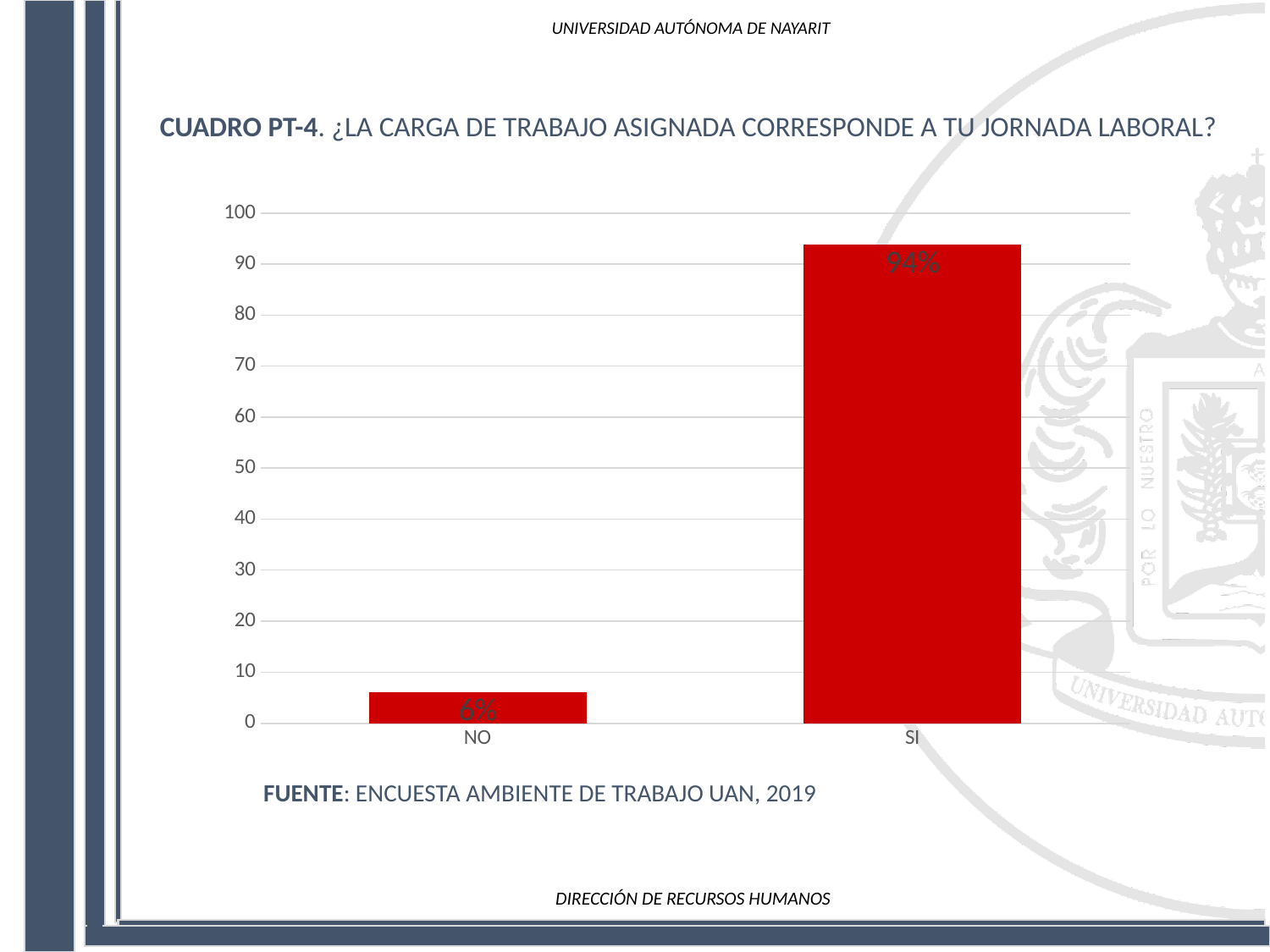
What is the value for SI? 94% Which category has the highest value? SI What kind of chart is shown on the slide? bar chart What colour are the bars in the chart? red Is the value for SI greater or less than 90? greater What is the difference between the values for SI and NO? 88% Which is larger, the value for NO or the value for SI? SI What is the value for NO? 6% Which category has the lowest value? NO Is the value for NO greater or less than 10? less How many categories are shown on the x axis? 2 What is the source cited below the chart? ENCUESTA AMBIENTE DE TRABAJO UAN, 2019